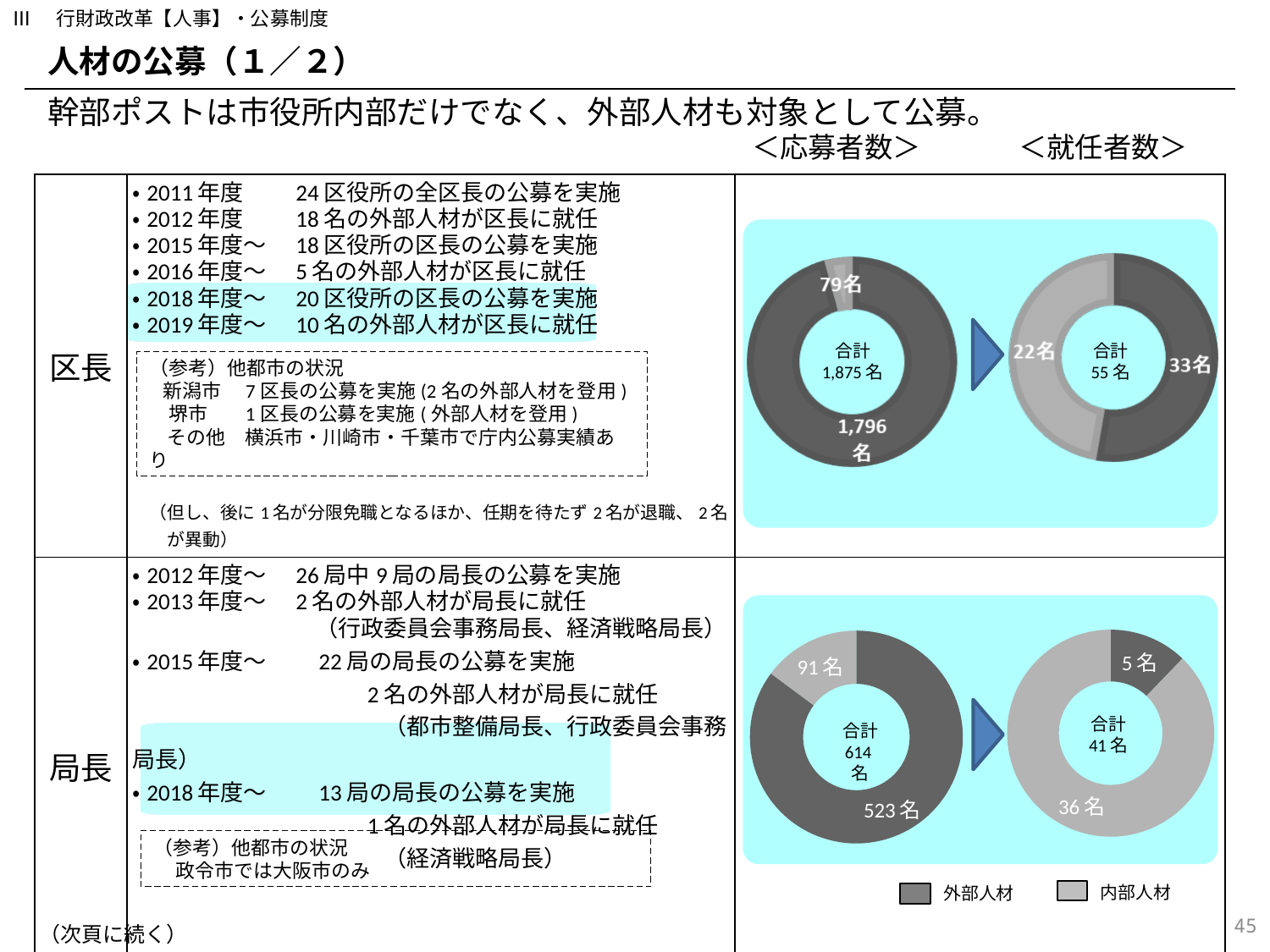
In the 局長 就任者数 donut chart, what is the difference between the two segments (36名 and 5名)? 31名 In the 区長 応募者数 donut chart, what is the total (合計) shown in the centre? 1,875 名 In the 局長 就任者数 donut chart, what is the value of the smaller segment? 5 名 In the 局長 応募者数 donut chart, what is the total (合計) shown in the centre? 614 名 What kind of chart is used to show 応募者数 and 就任者数 on this slide? Donut (pie) chart In the 区長 就任者数 donut chart, what is the difference between the two segments (33名 and 22名)? 11名 In the 局長 応募者数 donut chart, what is the value of the larger segment? 523 名 In the 区長 応募者数 donut chart, what is the value of the larger segment? 1,796 名 How many entries does the legend at the bottom right of the slide list? 2 In the 区長 就任者数 donut chart, what is the total (合計) shown in the centre? 55 名 In the 区長 応募者数 donut chart, what is the value of the smaller segment? 79名 In the 区長 就任者数 donut chart, which segment is larger, 22名 or 33名? 33名